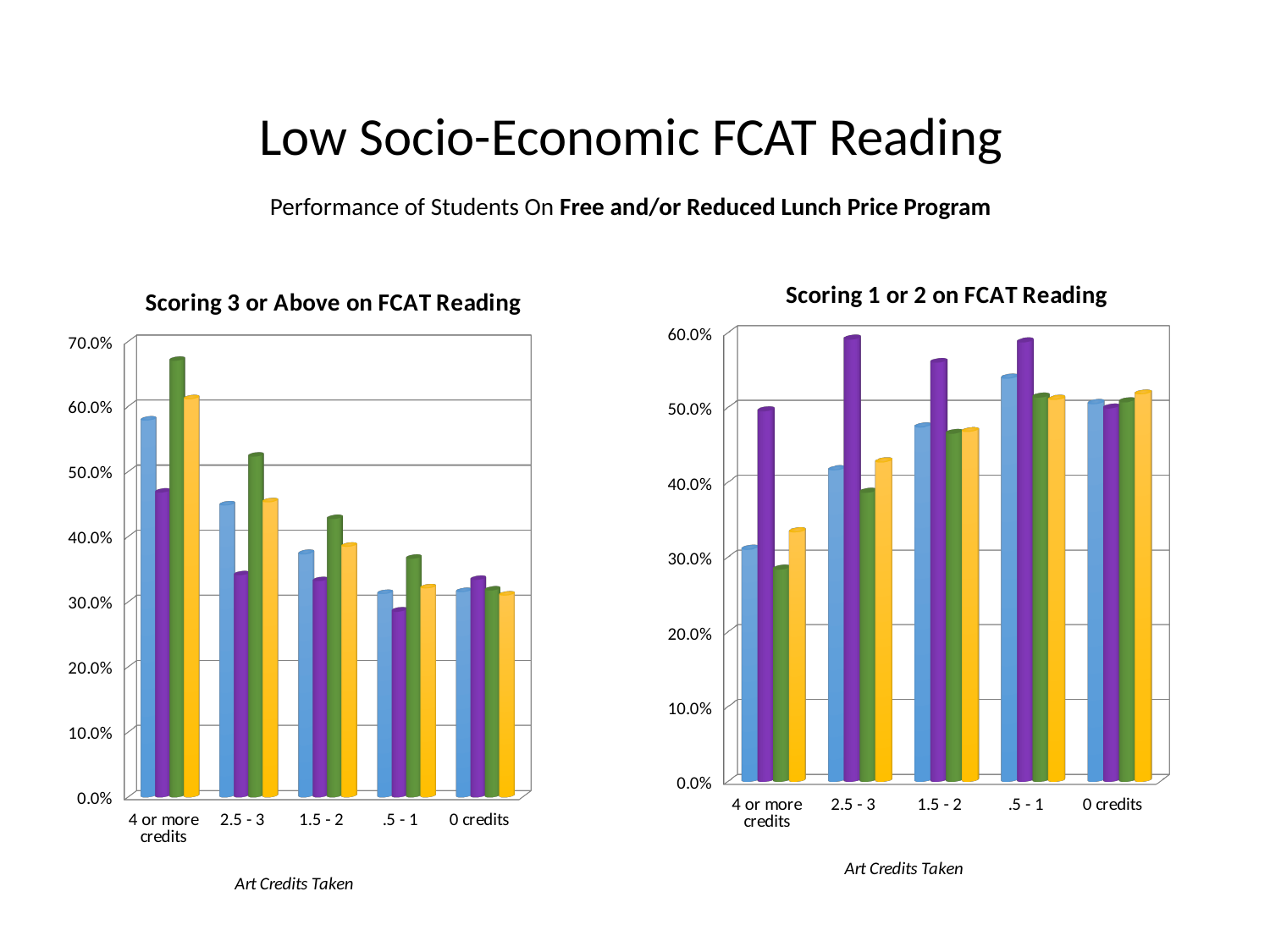
In the 'Scoring 1 or 2 on FCAT Reading' chart, is the tallest bar for '2.5 - 3' greater or less than 50.0%? greater What is the x-axis label shown beneath both charts? Art Credits Taken What kind of chart is the 'Scoring 3 or Above on FCAT Reading' chart? bar chart In the 'Scoring 1 or 2 on FCAT Reading' chart, is the shortest bar for '4 or more credits' greater or less than 40.0%? less What is the highest value shown on the y axis of the 'Scoring 1 or 2 on FCAT Reading' chart? 60.0% In the 'Scoring 3 or Above on FCAT Reading' chart, are all the bars for '0 credits' greater or less than 40.0%? less In the 'Scoring 3 or Above on FCAT Reading' chart, how many bars are plotted for each category? 4 How many categories are shown on the x axis of the 'Scoring 1 or 2 on FCAT Reading' chart? 5 In the 'Scoring 3 or Above on FCAT Reading' chart, do the tallest bars generally rise or fall moving from '4 or more credits' to '0 credits'? fall How many categories are shown on the x axis of the 'Scoring 3 or Above on FCAT Reading' chart? 5 In the 'Scoring 3 or Above on FCAT Reading' chart, which category has the taller tallest bar: '4 or more credits' or '0 credits'? 4 or more credits